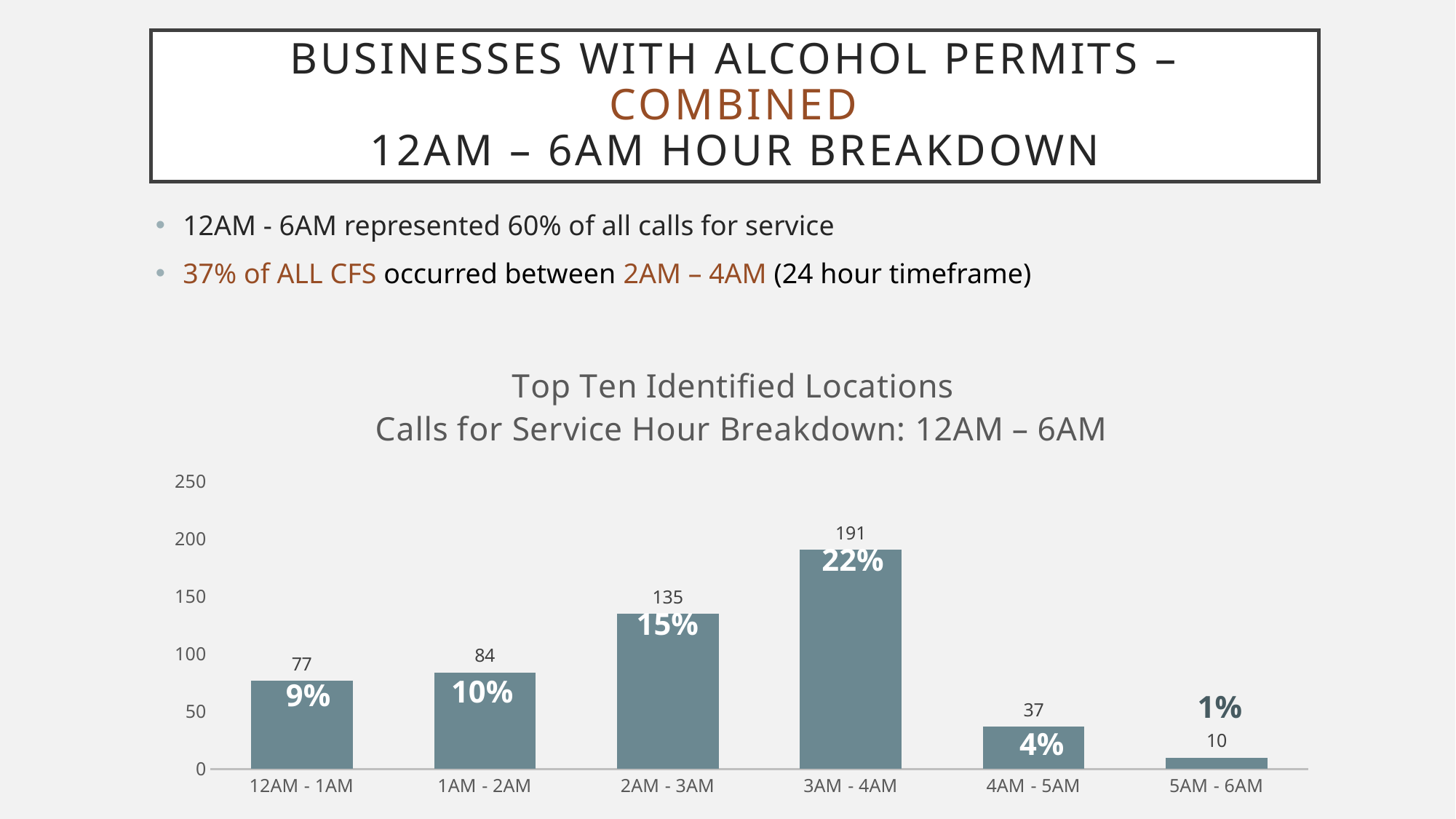
What kind of chart is shown? bar chart How many hour categories are shown on the x axis? 6 Which is larger, the value for 1AM - 2AM or the value for 4AM - 5AM? 1AM - 2AM Which hour has the lowest value? 5AM - 6AM What is the title of the chart? Top Ten Identified Locations Calls for Service Hour Breakdown: 12AM – 6AM What is the difference between the values for 3AM - 4AM and 2AM - 3AM? 56 What is the value for 3AM - 4AM? 191 What is the total of the values for 4AM - 5AM and 5AM - 6AM? 47 Which hour has the highest value? 3AM - 4AM What is the value for 12AM - 1AM? 77 What percentage label is shown on the 2AM - 3AM bar? 15% Is the value for 2AM - 3AM greater or less than 100? greater